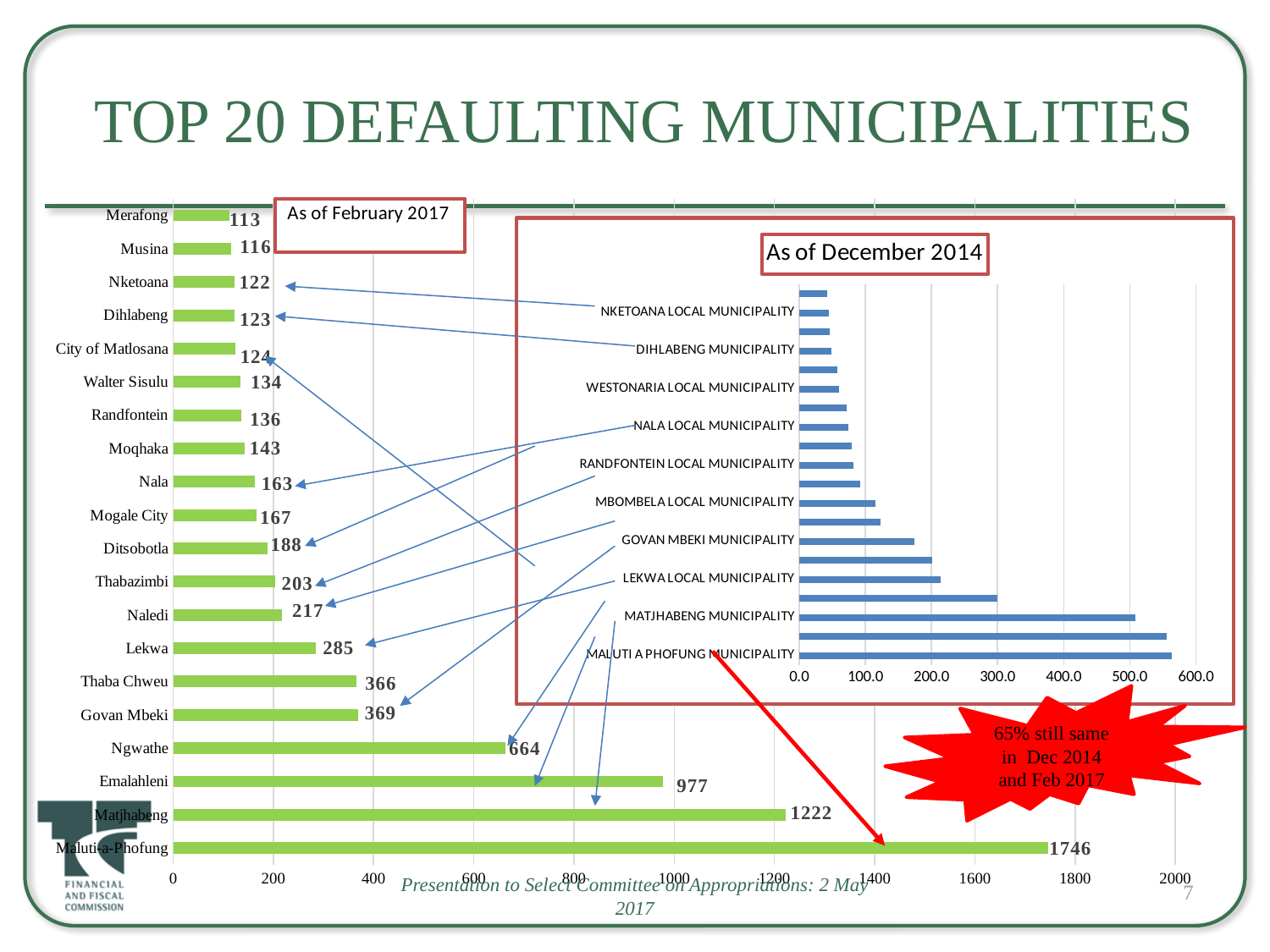
How many municipalities are shown in the 'As of February 2017' chart? 20 In the 'As of December 2014' chart, is the value for Maluti a Phofung Municipality greater or less than 500.0? greater In the 'As of February 2017' chart, what is the value for Maluti-a-Phofung? 1746 What kind of chart is the 'As of December 2014' chart? Bar chart In the 'As of February 2017' chart, which municipality has the lowest value? Merafong What is the title of the slide? TOP 20 DEFAULTING MUNICIPALITIES In the 'As of February 2017' chart, what is the value for Lekwa? 285 In the 'As of February 2017' chart, what is the difference between the values for Matjhabeng and Emalahleni? 245 In the 'As of February 2017' chart, which municipality has the highest value? Maluti-a-Phofung In the 'As of February 2017' chart, what is the value for Nketoana? 122 In the 'As of February 2017' chart, which is larger, the value for Ngwathe or the value for Govan Mbeki? Ngwathe In the 'As of December 2014' chart, is the value for Nketoana Local Municipality greater or less than 100.0? less